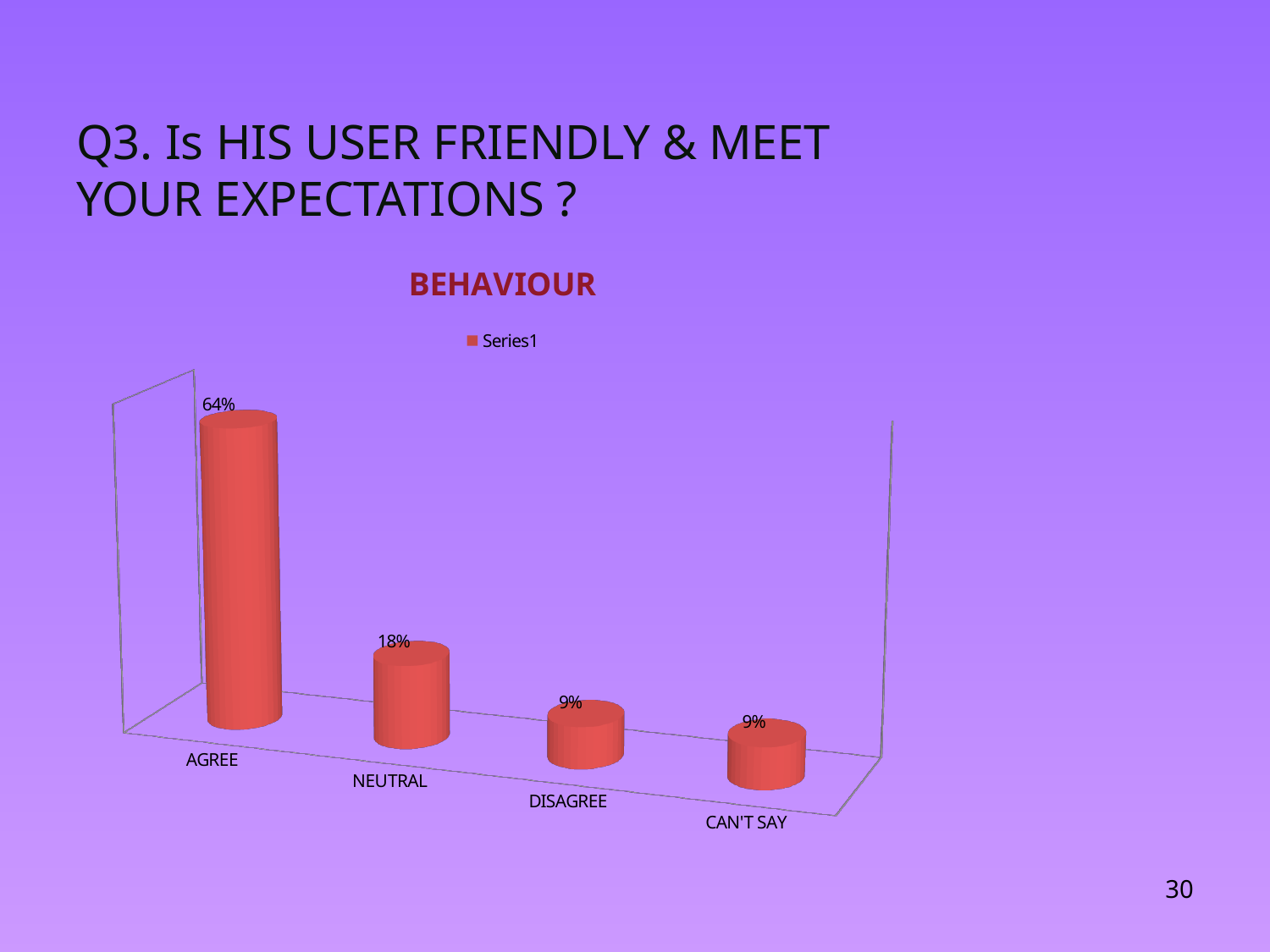
What kind of chart is shown on the slide? bar chart What is the value for AGREE? 64% What is the value for NEUTRAL? 18% Which is larger, the value for AGREE or the value for NEUTRAL? AGREE How many categories are shown on the chart? 4 Which category has the highest value? AGREE What is the value for DISAGREE? 9% What is the difference between the values for AGREE and NEUTRAL? 46% What is the title of the chart? BEHAVIOUR What is the value for CAN'T SAY? 9% What is the difference between the values for NEUTRAL and DISAGREE? 9% How many series does the legend list? 1